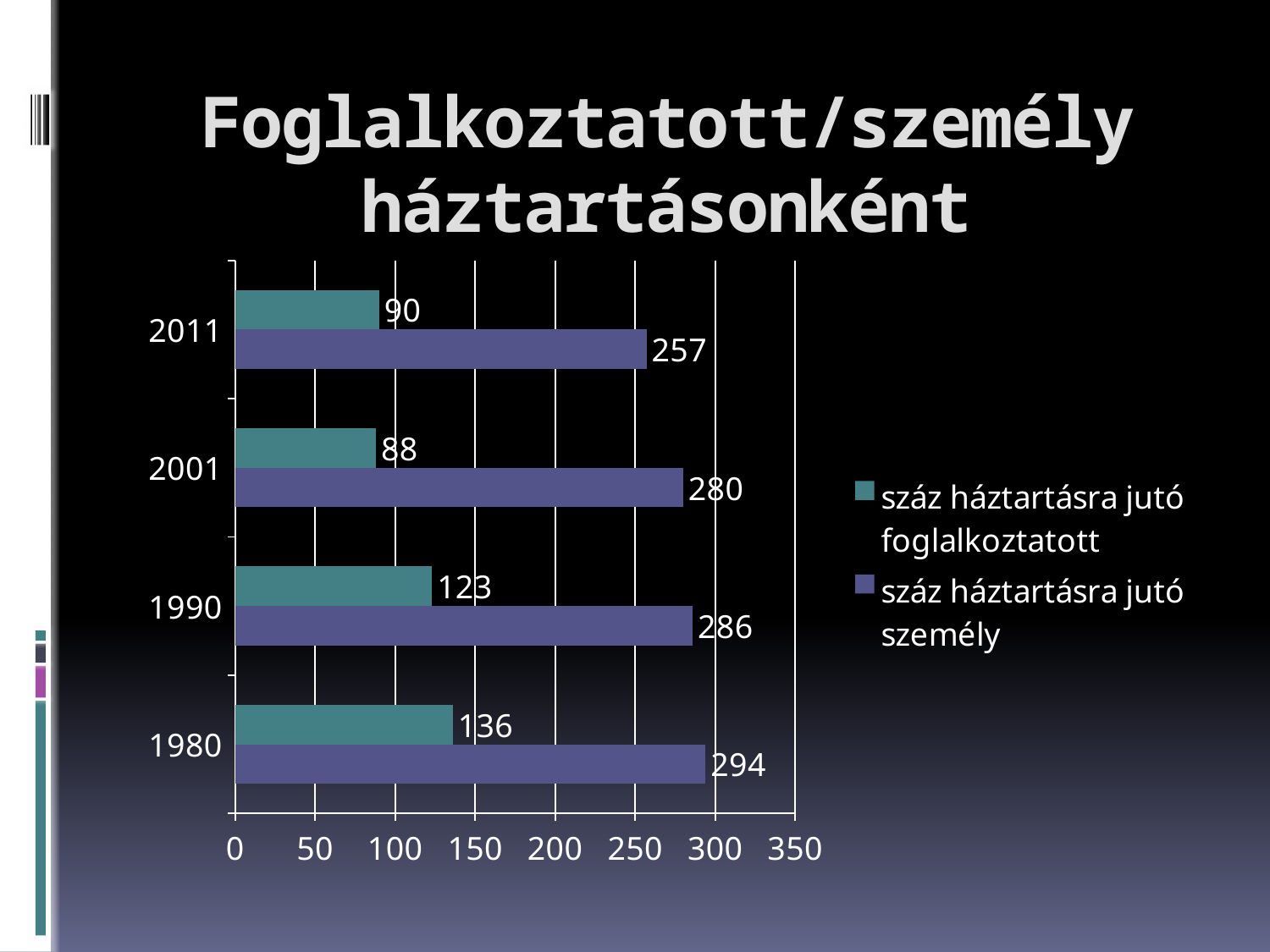
What is the value of 'száz háztartásra jutó személy' for 1980? 294 Which is larger: 'száz háztartásra jutó foglalkoztatott' in 1990 or in 2001? 1990 What is the value of 'száz háztartásra jutó foglalkoztatott' for 2011? 90 Which year has the highest value for 'száz háztartásra jutó foglalkoztatott'? 1980 What is the value of 'száz háztartásra jutó foglalkoztatott' for 1990? 123 How many years are shown on the chart? 4 What is the title of the chart? Foglalkoztatott/személy háztartásonként How many series does the legend list? 2 What is the value of 'száz háztartásra jutó személy' for 2001? 280 Which year has the lowest value for 'száz háztartásra jutó személy'? 2011 What is the difference between 'száz háztartásra jutó személy' in 1980 and in 2011? 37 What kind of chart is shown on the slide? bar chart